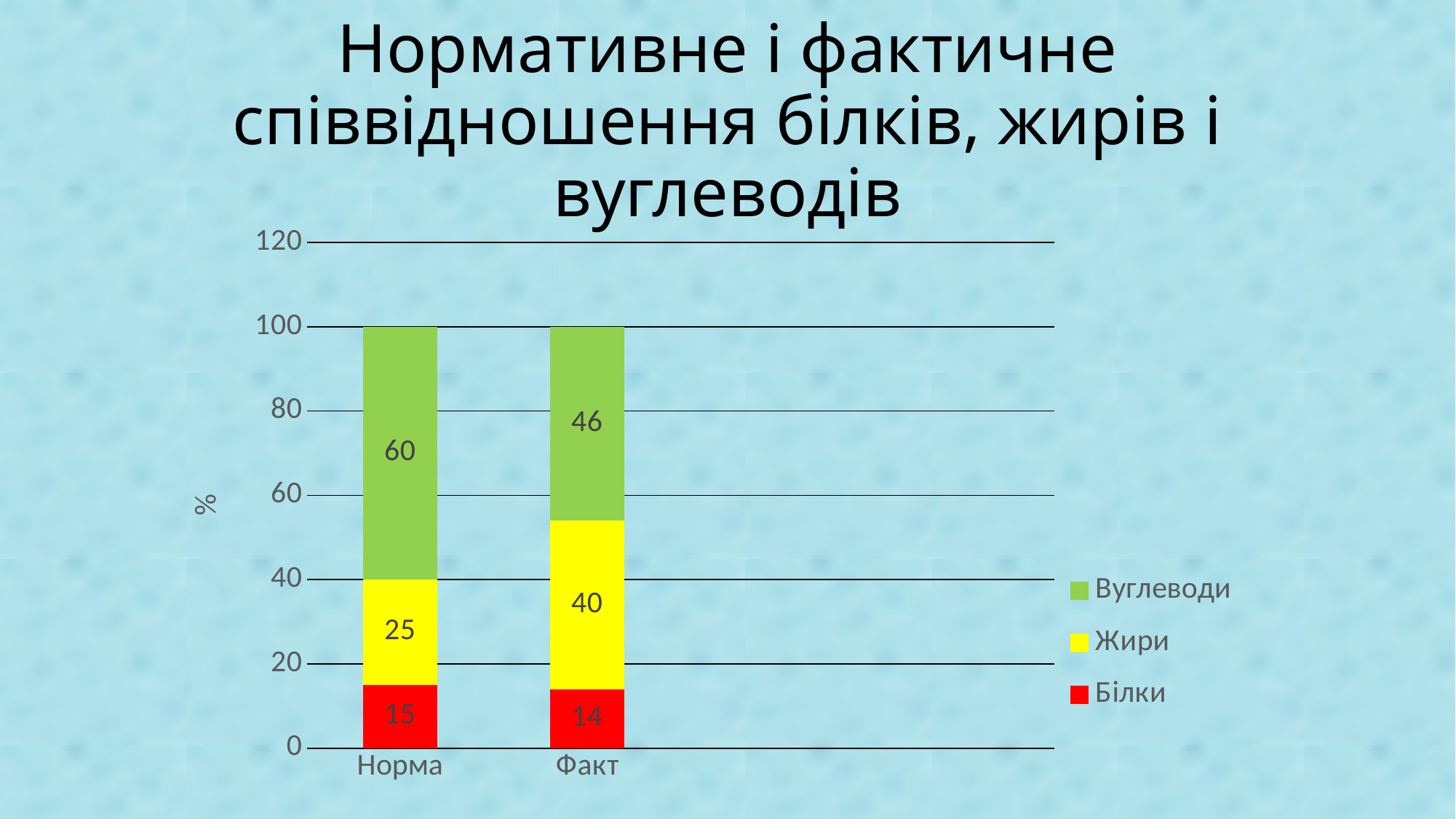
Which category has the higher value for Вуглеводи, Норма or Факт? Норма What is the difference between the Жири values for Факт and Норма? 15 How many categories are shown on the x axis? 2 What is the value for Вуглеводи in the Факт bar? 46 What is the value for Вуглеводи in the Норма bar? 60 What is the total of the Норма stacked bar? 100 What is the value for Жири in the Факт bar? 40 What kind of chart is shown on the slide? Stacked bar chart How many series does the legend list? 3 What is the value for Білки in the Норма bar? 15 Which series has the lowest value in the Факт bar? Білки What is the total of the Факт stacked bar? 100